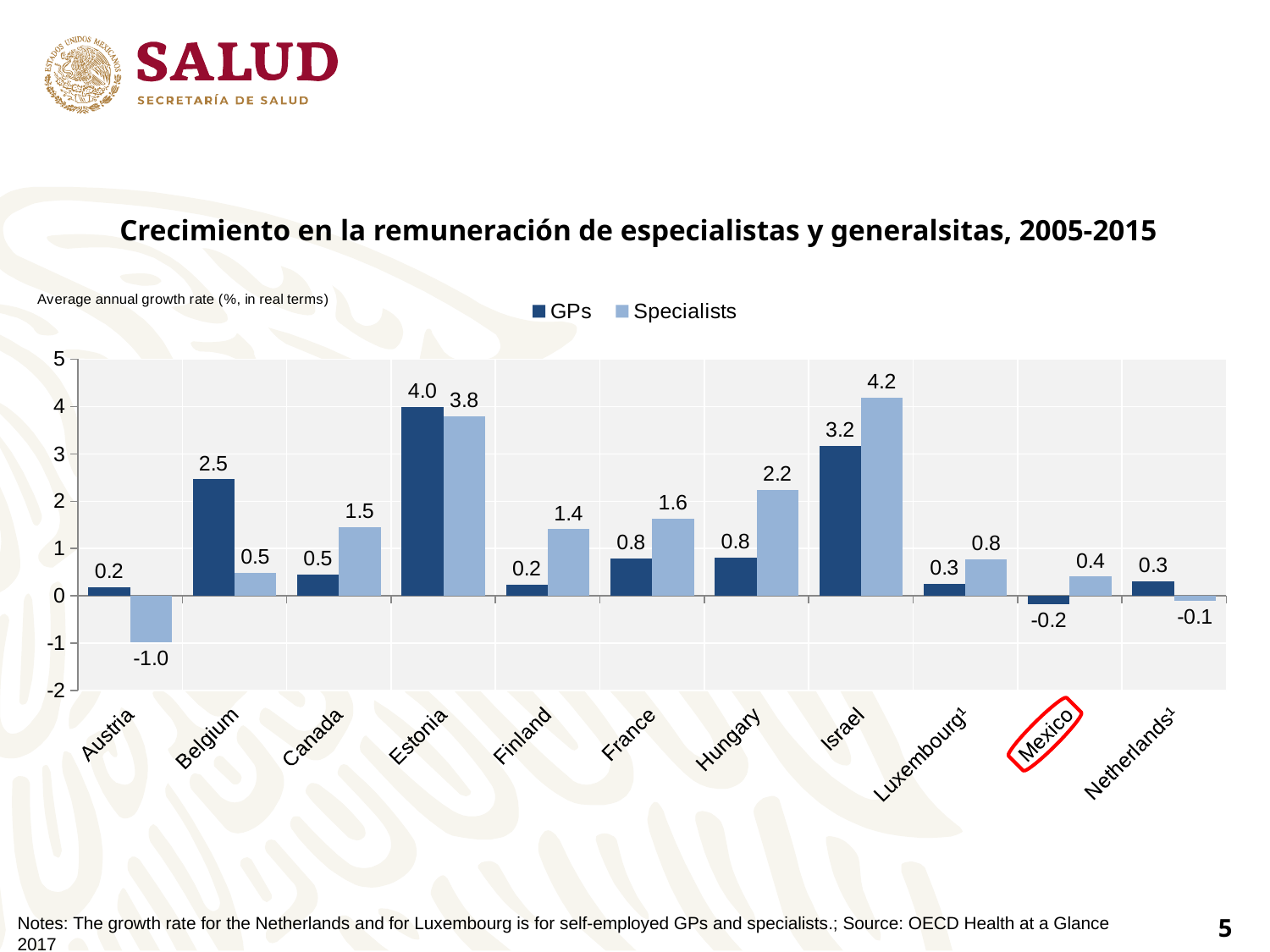
What is the difference between the GPs growth rates of Estonia and Israel? 0.8 How many countries are shown on the x axis? 11 Which is larger in Belgium, the growth rate for GPs or for Specialists? GPs What is the value for Specialists in Austria? -1.0 What is the average annual growth rate for Specialists in Mexico? 0.4 What is the difference between the Specialists and GPs growth rates in Hungary? 1.4 What kind of chart is shown on the slide? Bar chart How many series does the legend list? 2 What is the average annual growth rate for GPs in Estonia? 4.0 Which country has the highest growth rate for Specialists? Israel Which country label is circled in red on the x axis? Mexico Which country has the lowest growth rate for GPs? Mexico